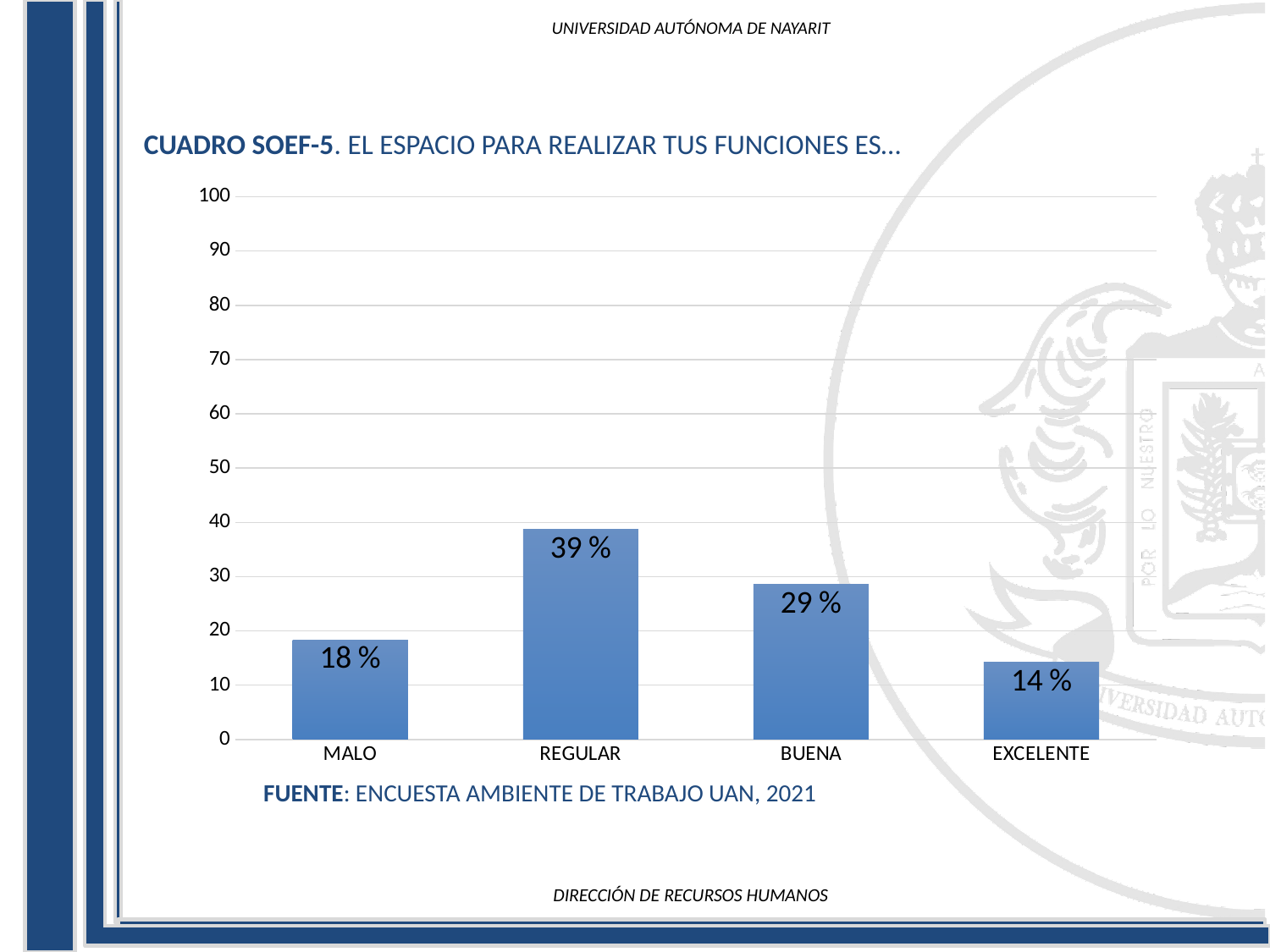
What is the highest value shown on the y axis? 100 What kind of chart is shown on the slide? bar chart What is the value for EXCELENTE? 14 % Which category has the highest value? REGULAR Which is larger, the value for MALO or the value for BUENA? BUENA What source is cited below the chart? ENCUESTA AMBIENTE DE TRABAJO UAN, 2021 How many categories are shown on the x axis? 4 What is the difference between the values for REGULAR and BUENA? 10 % What is the value for REGULAR? 39 % Which category has the lowest value? EXCELENTE What is the value for MALO? 18 % Is the value for BUENA greater or less than 20? greater